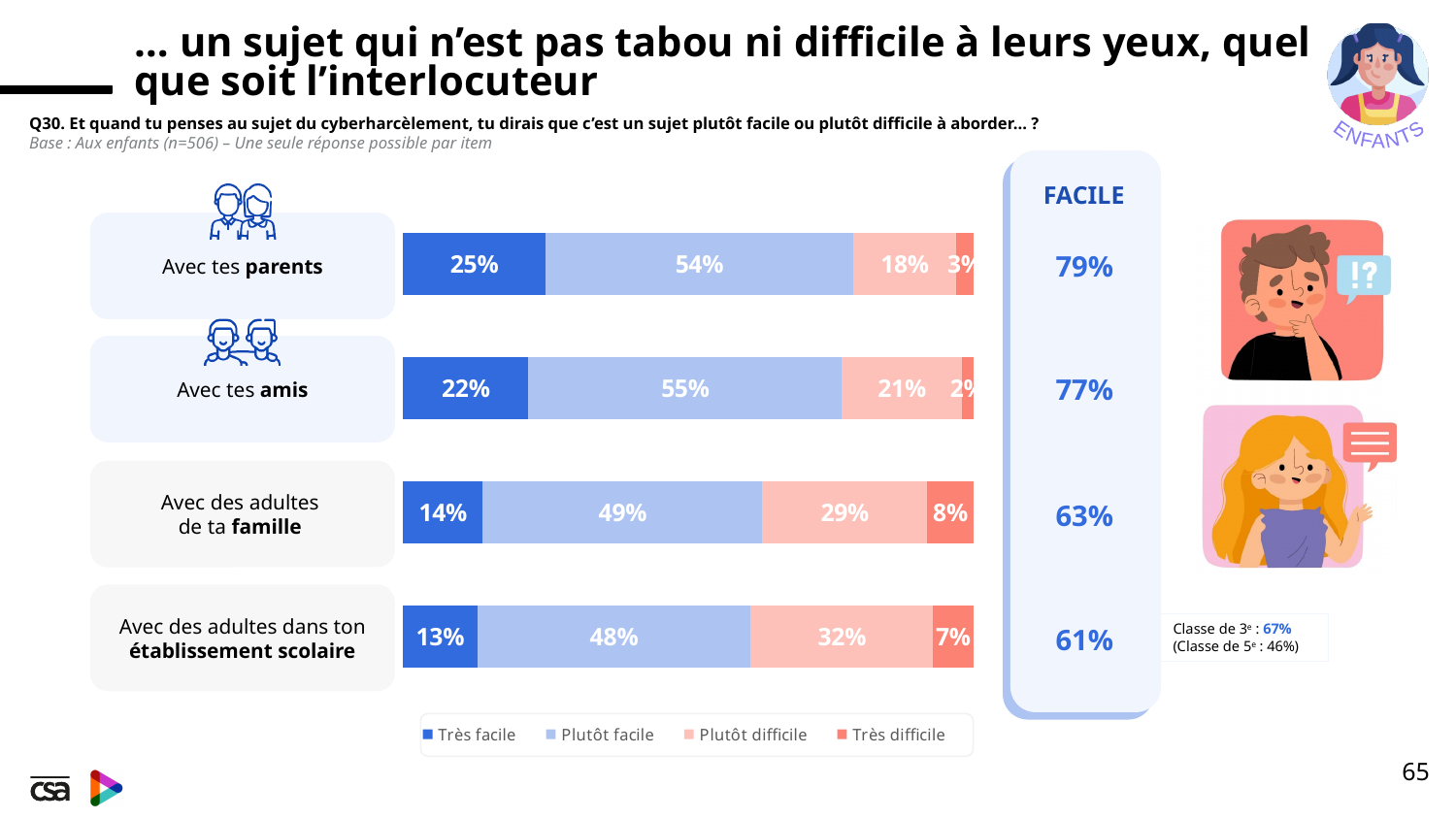
What is the combined "FACILE" total (Très facile + Plutôt facile) for "Avec des adultes de ta famille"? 63% What percentage of children say it is "Très facile" to talk about cyberbullying with their parents (Avec tes parents)? 25% Which is larger: the "Très difficile" value for "Avec des adultes de ta famille" or for "Avec tes amis"? Avec des adultes de ta famille What is the "Plutôt difficile" value for "Avec des adultes dans ton établissement scolaire"? 32% How many series does the legend list? 4 What is the "Plutôt facile" value for "Avec tes amis"? 55% What is the "Très difficile" value for "Avec des adultes de ta famille"? 8% Which category has the lowest "Très facile" value? Avec des adultes dans ton établissement scolaire What kind of chart is shown on the slide? Stacked bar chart What is the difference between the "Plutôt difficile" values for "Avec des adultes dans ton établissement scolaire" and "Avec tes parents"? 14 percentage points Which category has the highest "Très facile" value? Avec tes parents How many categories (interlocutors) are shown in the chart? 4